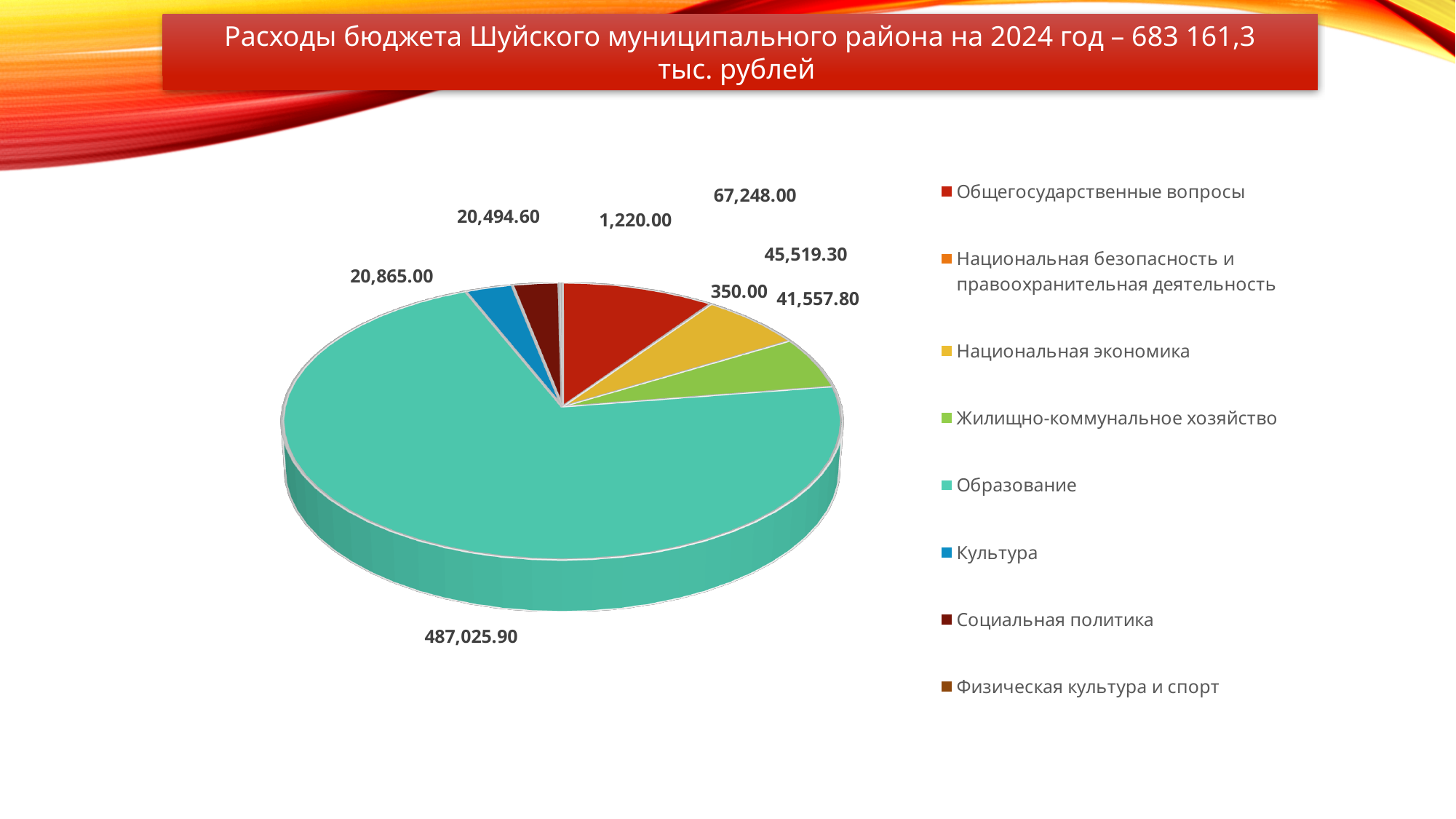
What colour is the slice for Образование? teal (green-blue) How many categories does the legend of the pie chart list? 8 What is the difference between the values for Общегосударственные вопросы and Национальная экономика? 21,728.70 What is the value shown for Общегосударственные вопросы? 67,248.00 What is the value shown for Образование? 487,025.90 What is the value shown for Жилищно-коммунальное хозяйство? 41,557.80 What is the title of the chart on the slide? Расходы бюджета Шуйского муниципального района на 2024 год – 683 161,3 тыс. рублей Which category has the largest slice of the pie? Образование What is the smallest value labelled on the pie chart? 350.00 Which is larger, the value for Национальная экономика or the value for Жилищно-коммунальное хозяйство? Национальная экономика What kind of chart is shown on the slide? pie chart What is the value shown for Национальная экономика? 45,519.30